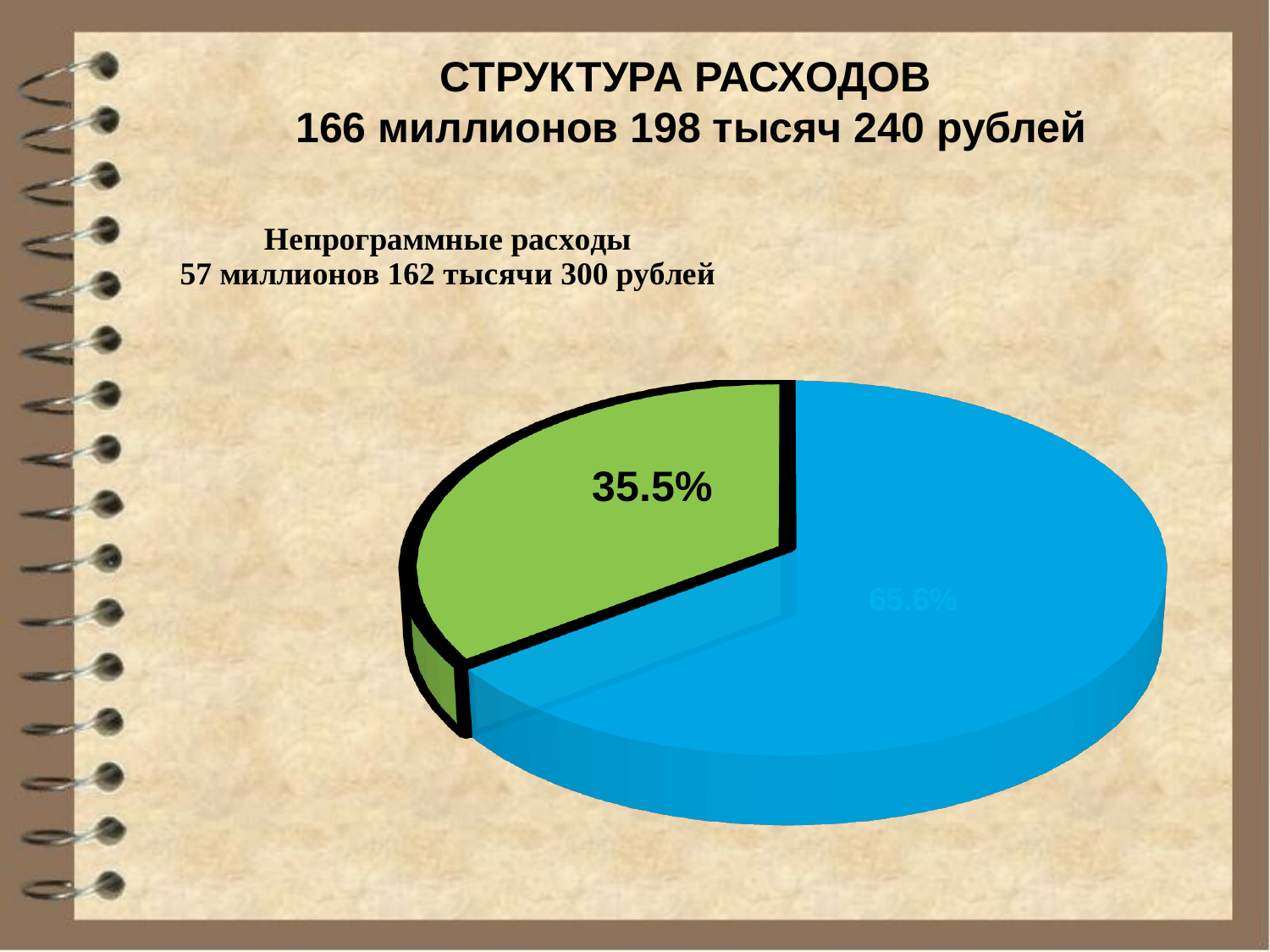
How many slices does the pie chart have? 2 What percentage is printed on the green slice of the pie chart? 35.5% What is the title of the chart on the slide? СТРУКТУРА РАСХОДОВ 166 миллионов 198 тысяч 240 рублей What colour is the slice labelled Непрограммные расходы? green What percentage is printed on the blue slice of the pie chart? 65.6% What share of the pie do the Непрограммные расходы (green slice) represent? 35.5% Is the share of the green slice greater or less than 50%? less Which slice of the pie chart is the largest? the blue slice (65.6%) Which slice is larger, the green one or the blue one? the blue one Which slice of the pie chart is the smallest? the green slice (Непрограммные расходы, 35.5%) What kind of chart is shown on the slide? pie chart